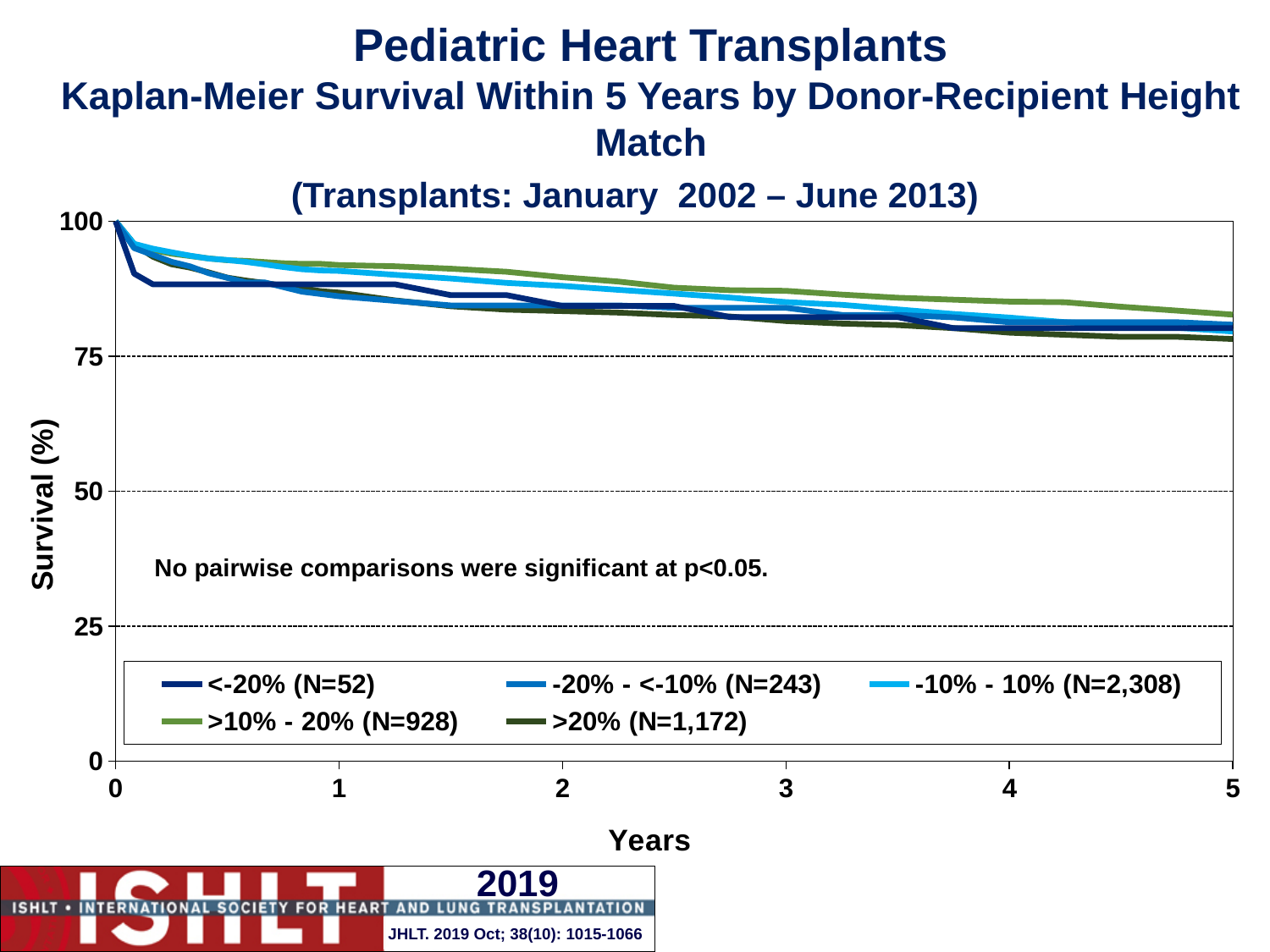
What kind of chart is shown on the slide? line chart Which group has the highest survival at 5 years? >10% - 20% (N=928) Is the survival value for the >10% - 20% group at 3 years greater or less than 50? greater What is the label of the y axis? Survival (%) What is the N for the -10% - 10% group shown in the legend? 2,308 Is the survival value for the >20% group at 5 years greater or less than 75? greater How many series does the legend list? 5 Is the survival value for the -10% - 10% group at 5 years greater or less than 75? greater What is the maximum value shown on the x axis? 5 Do the survival curves rise or fall as years increase? fall